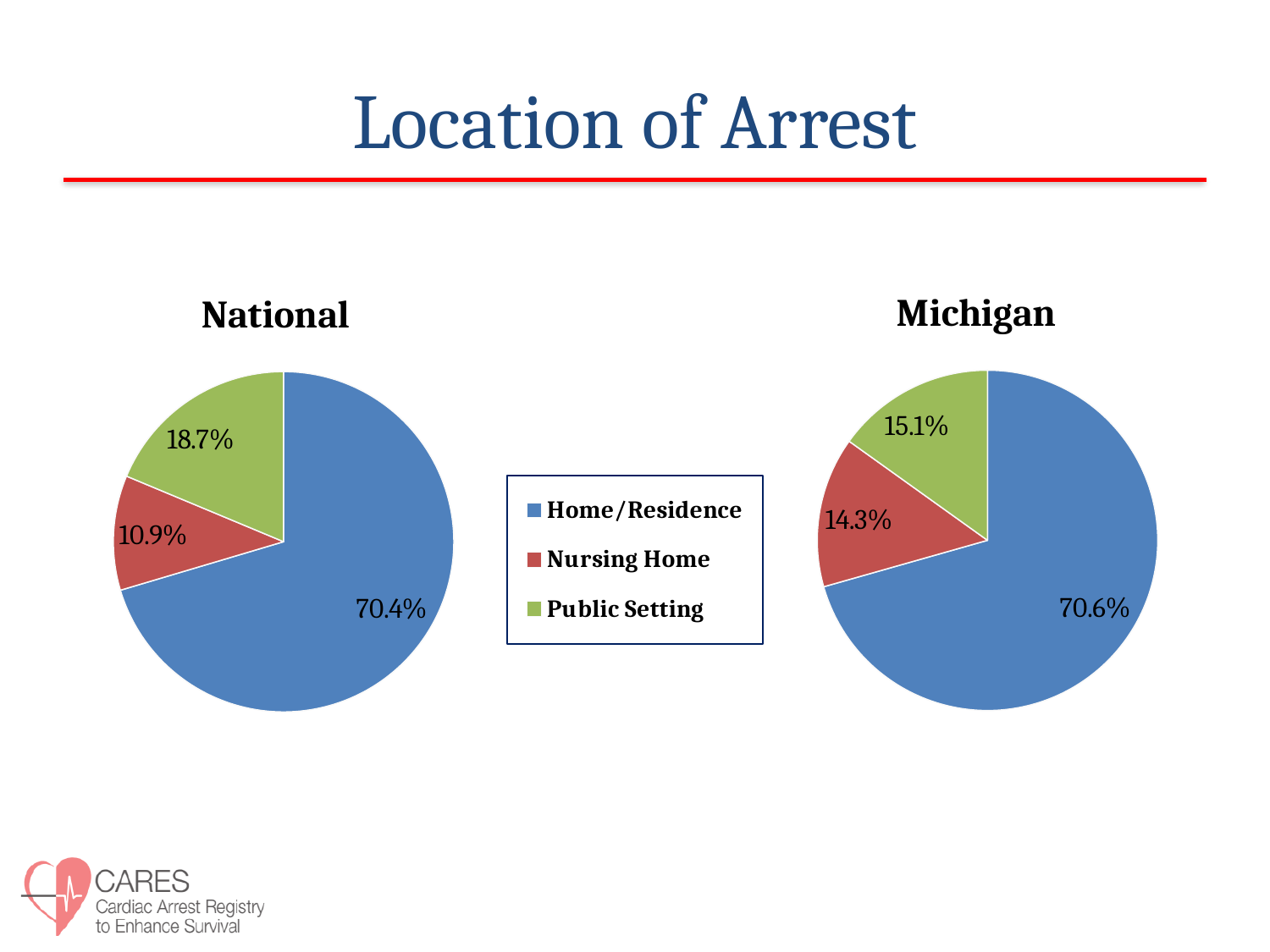
In the Michigan pie chart, which location has the smallest share? Nursing Home In the Michigan pie chart, what percentage of arrests occurred in a Public Setting? 15.1% In the National pie chart, what percentage of arrests occurred at Home/Residence? 70.4% What type of chart is used to show the National location of arrest data? Pie chart In the National pie chart, which location has the largest share? Home/Residence In the National pie chart, what percentage of arrests occurred in a Nursing Home? 10.9% Which is larger: the Nursing Home share in the National chart or the Nursing Home share in the Michigan chart? Michigan How many slices does the Michigan pie chart have? 3 Which colour represents Public Setting in the legend? Green What is the difference between the Public Setting share in the National chart and the Public Setting share in the Michigan chart? 3.6% In the National pie chart, which location has the smallest share? Nursing Home In the Michigan pie chart, what percentage of arrests occurred in a Nursing Home? 14.3%